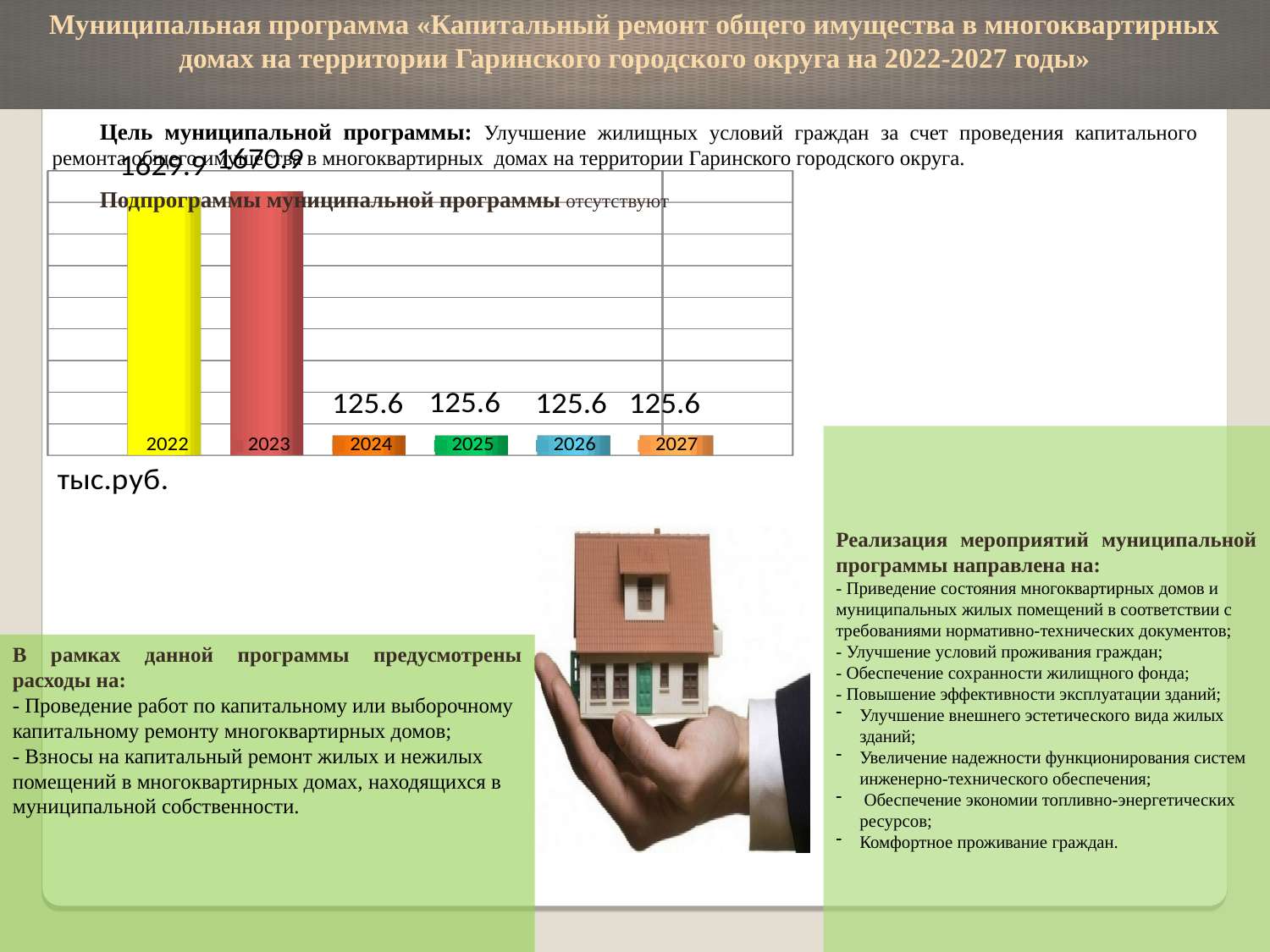
How many years are shown on the x axis of the bar chart? 6 What unit is indicated below the bar chart? тыс.руб. Which year has the highest value in the bar chart? 2023 Which is larger in the bar chart, the value for 2023 or the value for 2024? 2023 What is the value for 2027 in the bar chart? 125.6 What is the difference between the values for 2025 and 2026 in the bar chart? 0 Do the values rise or fall from 2023 to 2024 in the bar chart? fall What is the value for 2023 in the bar chart? 1670.9 What kind of chart is shown on the slide? bar chart What is the value for 2024 in the bar chart? 125.6 What is the difference between the values for 2023 and 2024 in the bar chart? 1545.3 Which years share the lowest value in the bar chart? 2024, 2025, 2026, 2027